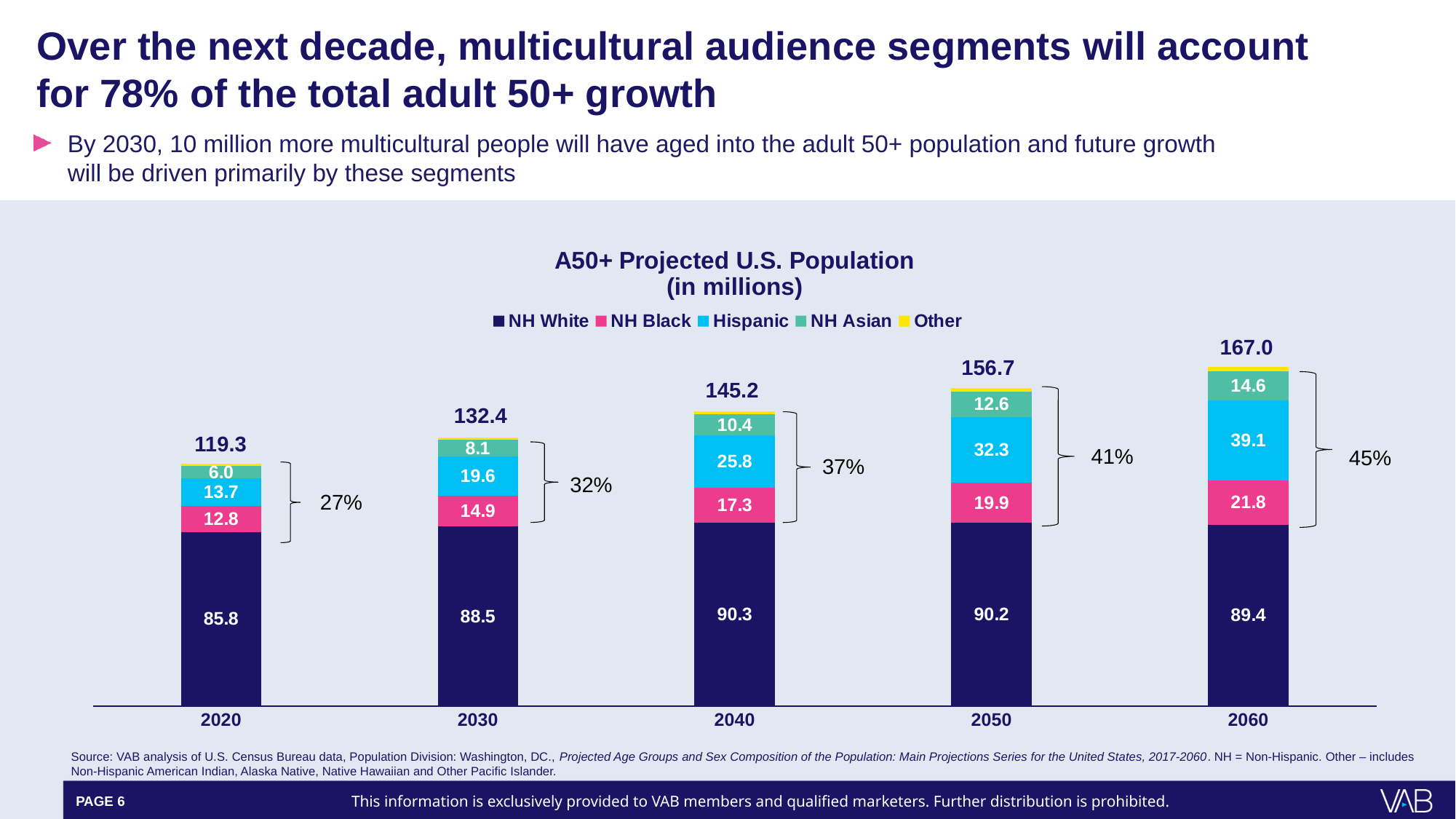
Which year has the highest total A50+ projected population? 2060 What is the Hispanic value for 2060? 39.1 How many years are shown on the x axis? 5 What is the difference between the Hispanic value in 2060 and in 2020? 25.4 What is the NH Asian value for 2040? 10.4 What kind of chart is shown on the slide? Stacked bar chart What is the total of the stacked bar for 2050? 156.7 What is the NH White value for 2020? 85.8 How many series does the legend list? 5 What is the difference between the total for 2060 and the total for 2020? 47.7 Which year has the lowest total A50+ projected population? 2020 Which is larger in 2050, the NH Black value or the Hispanic value? Hispanic